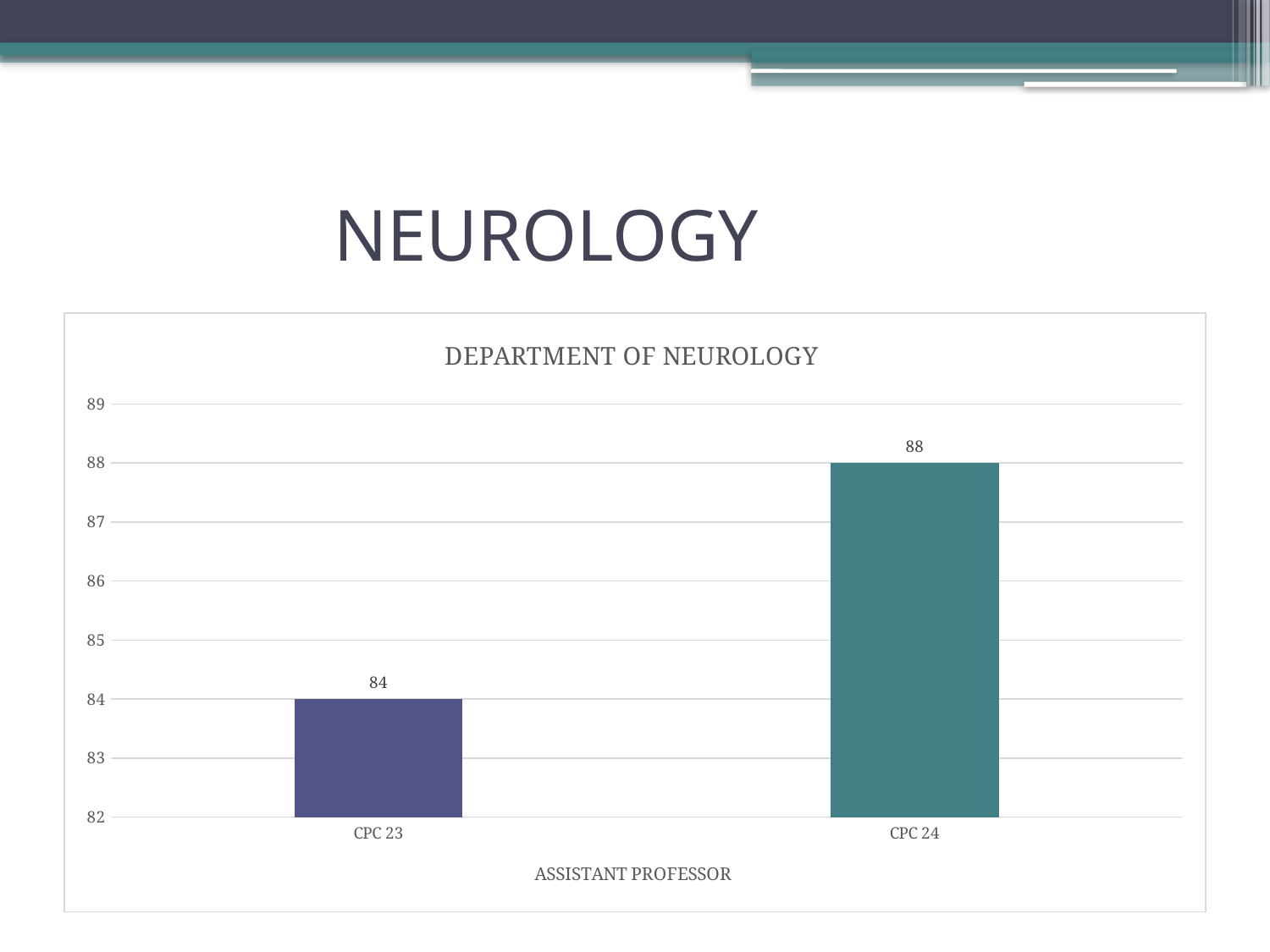
What kind of chart is shown on the slide? bar chart What is the title of the chart? DEPARTMENT OF NEUROLOGY Is the value for CPC 24 greater or less than 86? greater Is the value for CPC 23 greater or less than 86? less Which category has the lowest value? CPC 23 Do the values rise or fall from CPC 23 to CPC 24? rise Which is larger, the value for CPC 23 or the value for CPC 24? CPC 24 What is the value for CPC 24? 88 How many categories are shown on the x axis? 2 What is the value for CPC 23? 84 Which category has the highest value? CPC 24 What is the difference between the values for CPC 24 and CPC 23? 4